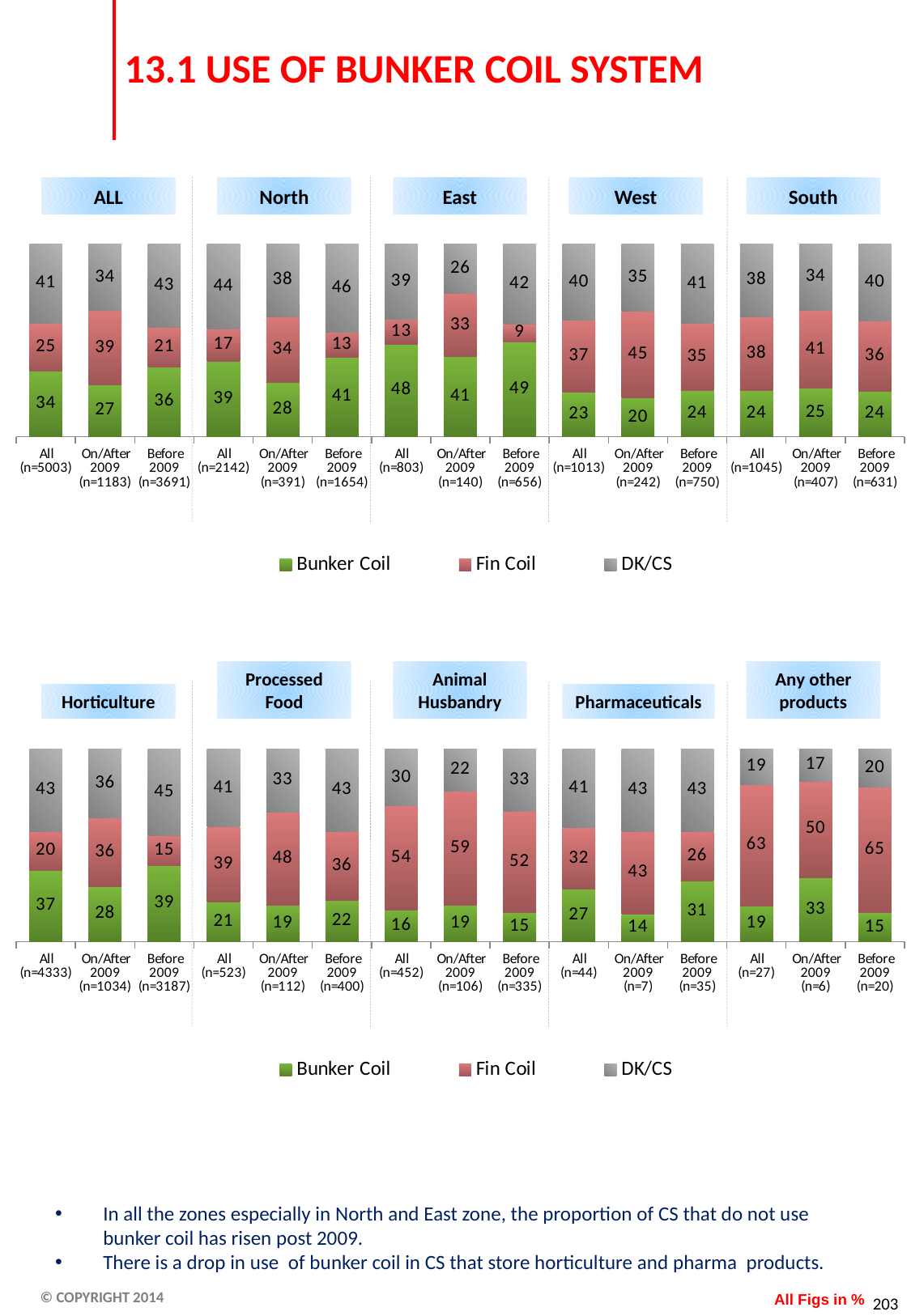
In the top chart, what is the Bunker Coil value for East All (n=803)? 48 What kind of chart is the top chart? Stacked bar chart In the top chart, what is the Fin Coil value for West On/After 2009 (n=242)? 45 How many bars are plotted in the bottom chart? 15 In the bottom chart, what is the Fin Coil value for Any other products Before 2009 (n=20)? 65 In the bottom chart, which is larger: the Bunker Coil value for Horticulture All or for Processed Food All? Horticulture All In the bottom chart, what is the DK/CS value for Horticulture Before 2009 (n=3187)? 45 In the bottom chart, what is the total of the stacked bar for Animal Husbandry On/After 2009 (n=106)? 100 In the bottom chart, which bar has the lowest Bunker Coil value? Pharmaceuticals On/After 2009 (n=7) In the top chart, what is the difference between the Fin Coil values for ALL On/After 2009 and ALL Before 2009? 18 In the top chart, which bar has the highest Bunker Coil value? East Before 2009 (n=656) How many series does the legend of the top chart list? 3